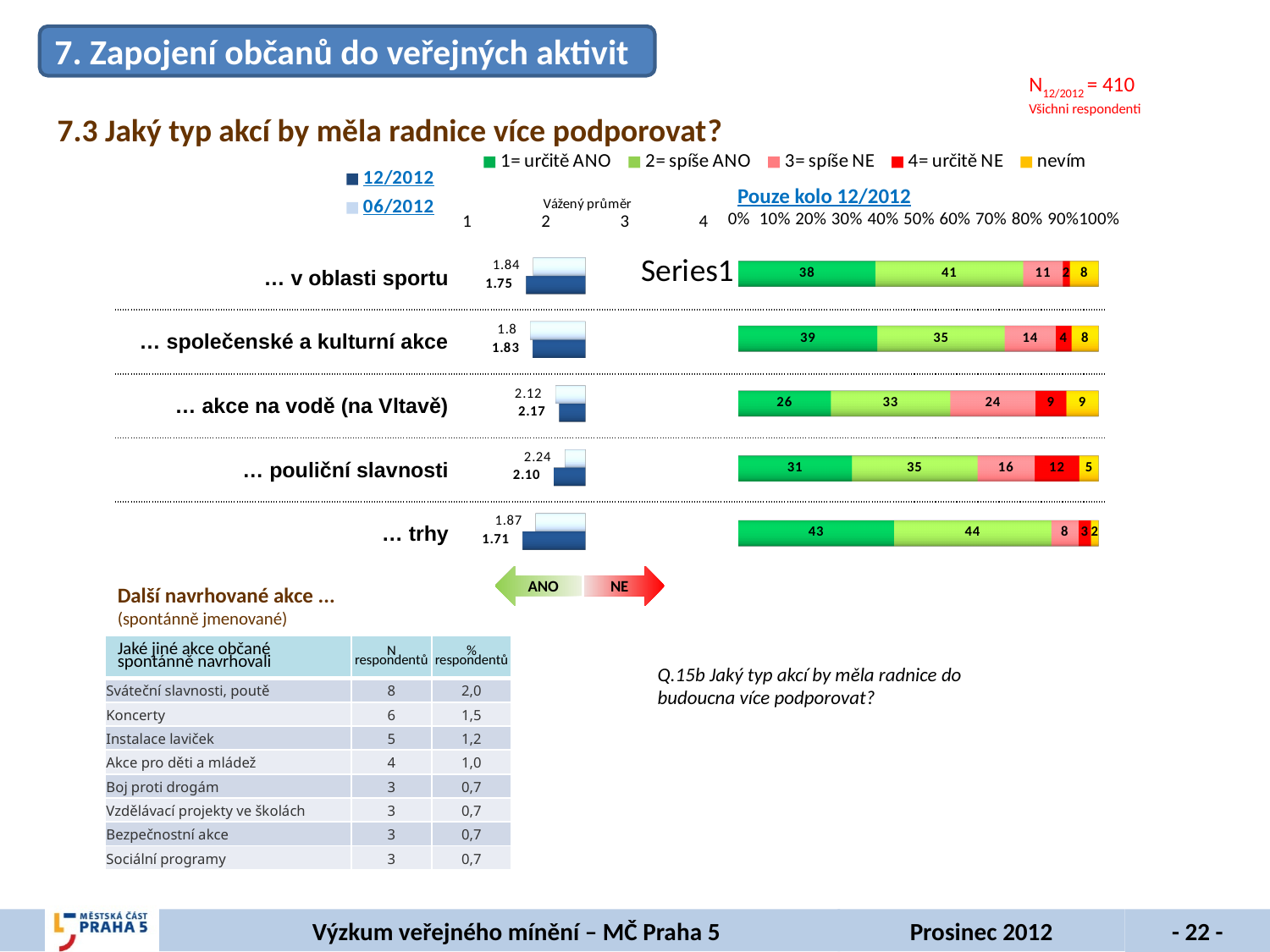
In the 'Vážený průměr' bar chart, what is the 12/2012 value for '… trhy'? 1.71 In the stacked bar chart 'Pouze kolo 12/2012', which category has the highest '1= určitě ANO' value? … trhy In the stacked bar chart 'Pouze kolo 12/2012', what is the value of '1= určitě ANO' for '… trhy'? 43 In the stacked bar chart 'Pouze kolo 12/2012', is the 'nevím' value larger for '… akce na vodě (na Vltavě)' or for '… pouliční slavnosti'? … akce na vodě (na Vltavě) How many categories are shown in the stacked bar chart 'Pouze kolo 12/2012'? 5 In the stacked bar chart 'Pouze kolo 12/2012', which category has the lowest '1= určitě ANO' value? … akce na vodě (na Vltavě) What kind of chart is the 'Pouze kolo 12/2012' chart? Stacked bar chart In the stacked bar chart 'Pouze kolo 12/2012', what is the difference between the '2= spíše ANO' values for '… v oblasti sportu' and '… společenské a kulturní akce'? 6 In the stacked bar chart 'Pouze kolo 12/2012', what is the value of '3= spíše NE' for '… akce na vodě (na Vltavě)'? 24 In the stacked bar chart 'Pouze kolo 12/2012', what is the value of '4= určitě NE' for '… pouliční slavnosti'? 12 How many series does the legend of the stacked bar chart 'Pouze kolo 12/2012' list? 5 In the 'Vážený průměr' bar chart, what is the 06/2012 value for '… pouliční slavnosti'? 2.24